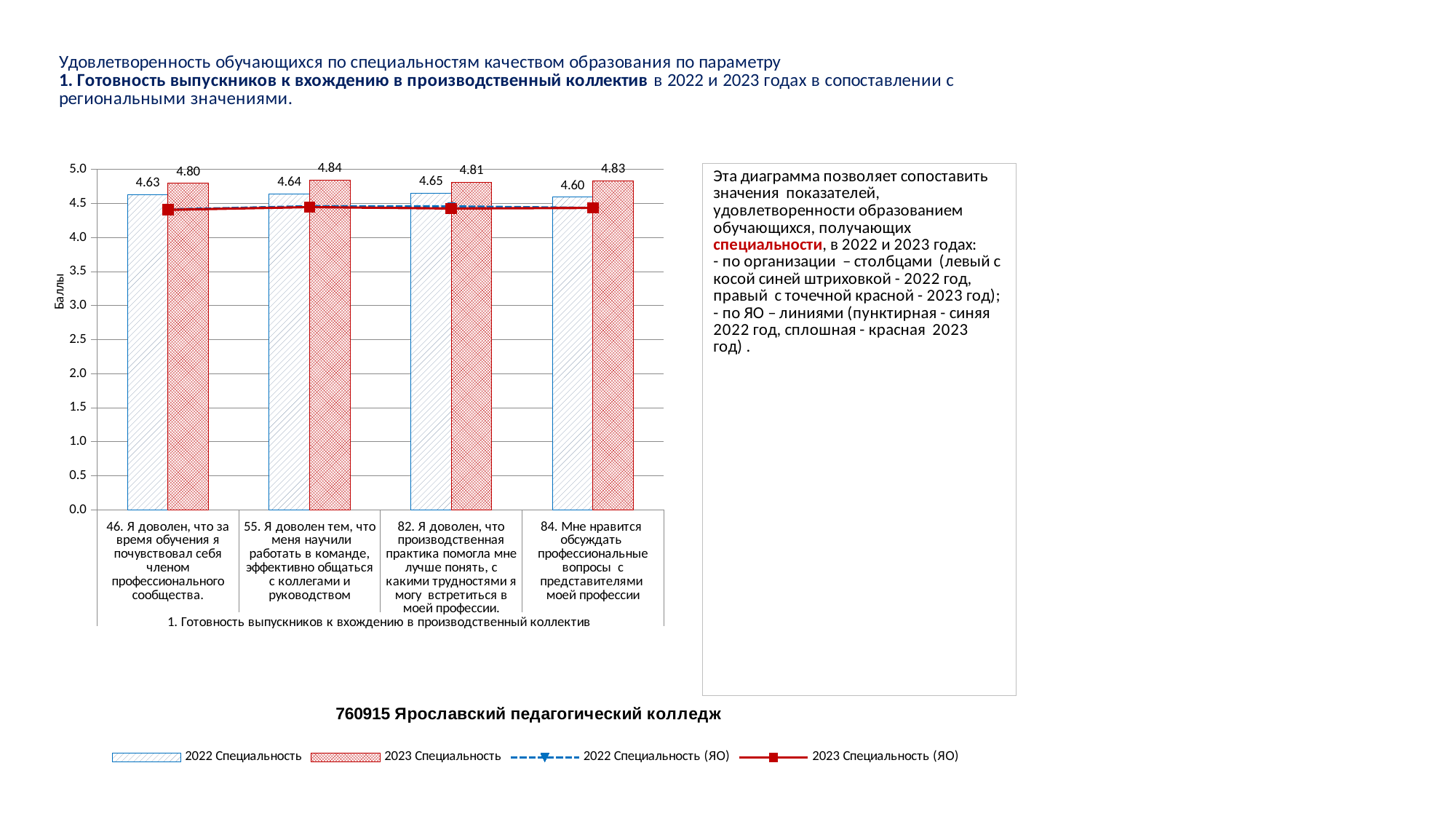
What is the 2023 Специальность value for item 55 (Я доволен тем, что меня научили работать в команде)? 4.84 Which item has the lowest 2022 Специальность value? 84. Мне нравится обсуждать профессиональные вопросы с представителями моей профессии What is the label of the vertical axis of the chart? Баллы How many items (categories) are shown on the x axis of the chart? 4 What is the difference between the 2023 and 2022 Специальность values for item 84? 0.23 What is the 2022 Специальность value for item 46 (Я доволен, что за время обучения я почувствовал себя членом профессионального сообщества)? 4.63 What is the 2023 Специальность value for item 82 (Я доволен, что производственная практика помогла мне лучше понять...)? 4.81 For item 46, which is larger: the 2022 Специальность value or the 2023 Специальность value? 2023 Специальность What is the 2022 Специальность value for item 84 (Мне нравится обсуждать профессиональные вопросы с представителями моей профессии)? 4.60 How many series does the chart legend list? 4 Which item has the highest 2023 Специальность value? 55. Я доволен тем, что меня научили работать в команде, эффективно общаться с коллегами и руководством